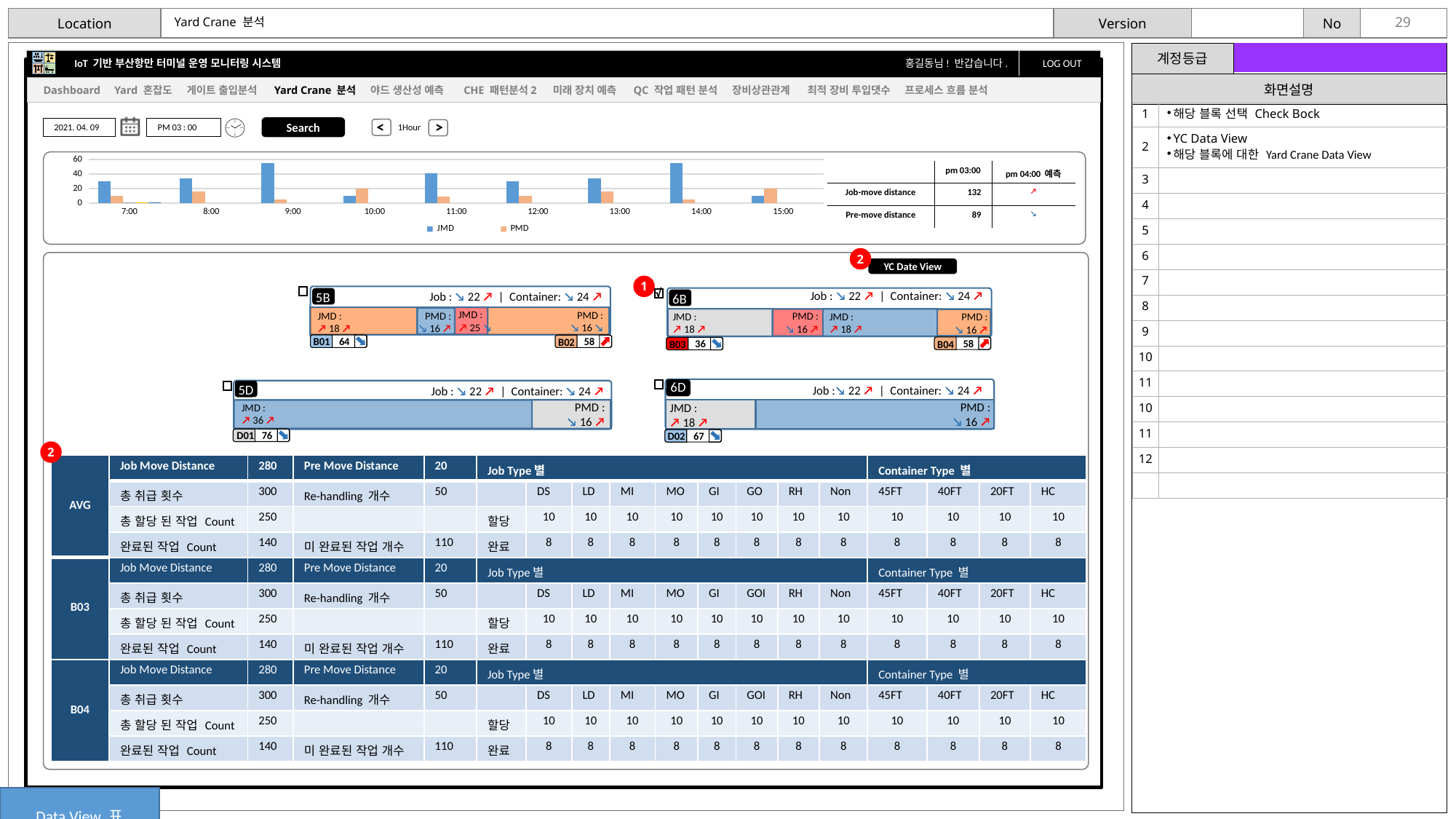
What are the two series names shown in the legend of the top bar chart? JMD and PMD In the top bar chart, is the JMD value at 9:00 greater or less than 40? greater In the top bar chart, is the JMD value at 10:00 greater or less than 20? less In the top bar chart, which series has the larger value at 10:00, JMD or PMD? PMD How many time points are plotted along the x axis of the top bar chart? 9 How many series does the legend of the top bar chart list? 2 In the top bar chart, which series has the larger value at 9:00, JMD or PMD? JMD What kind of chart is shown at the top of the slide? bar chart In the top bar chart, is the PMD value at 9:00 greater or less than 20? less In the top bar chart, which series has the larger value at 15:00, JMD or PMD? PMD